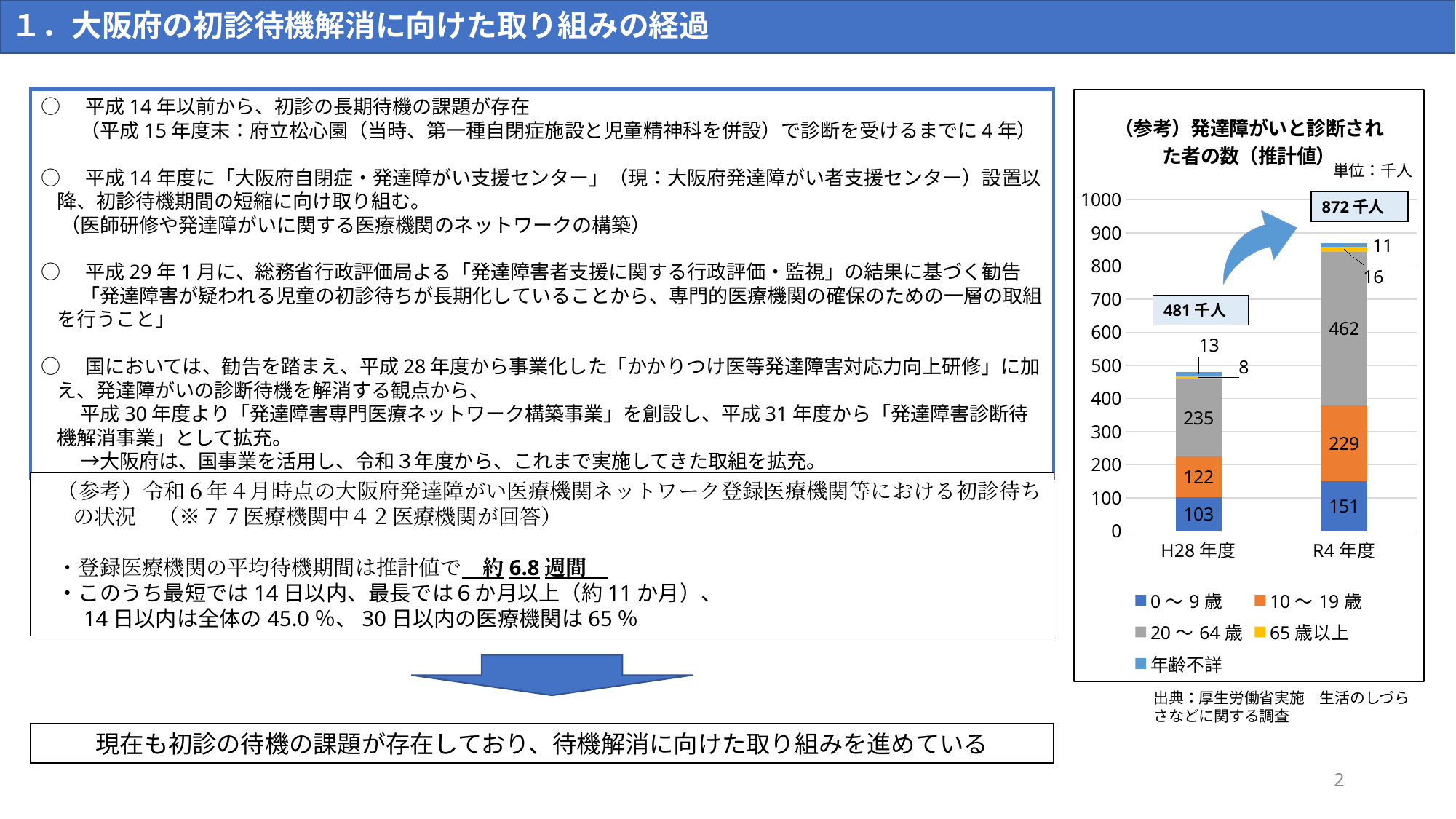
By how much did the 20～64歳 value increase from H28年度 to R4年度? 227 What is the value for 0～9歳 in H28年度? 103 What kind of chart is shown on the slide? Stacked bar chart Which age group has the largest value in the R4年度 bar? 20～64歳 What is the total shown for the H28年度 bar? 481千人 Which year has the larger value for 0～9歳, H28年度 or R4年度? R4年度 What is the total shown for the R4年度 bar? 872千人 How many series does the chart's legend list? 5 What is the value for 10～19歳 in R4年度? 229 What unit is stated for the values in the chart? 千人 How many fiscal-year categories are plotted on the x axis of the chart? 2 What is the value for 20～64歳 in R4年度? 462